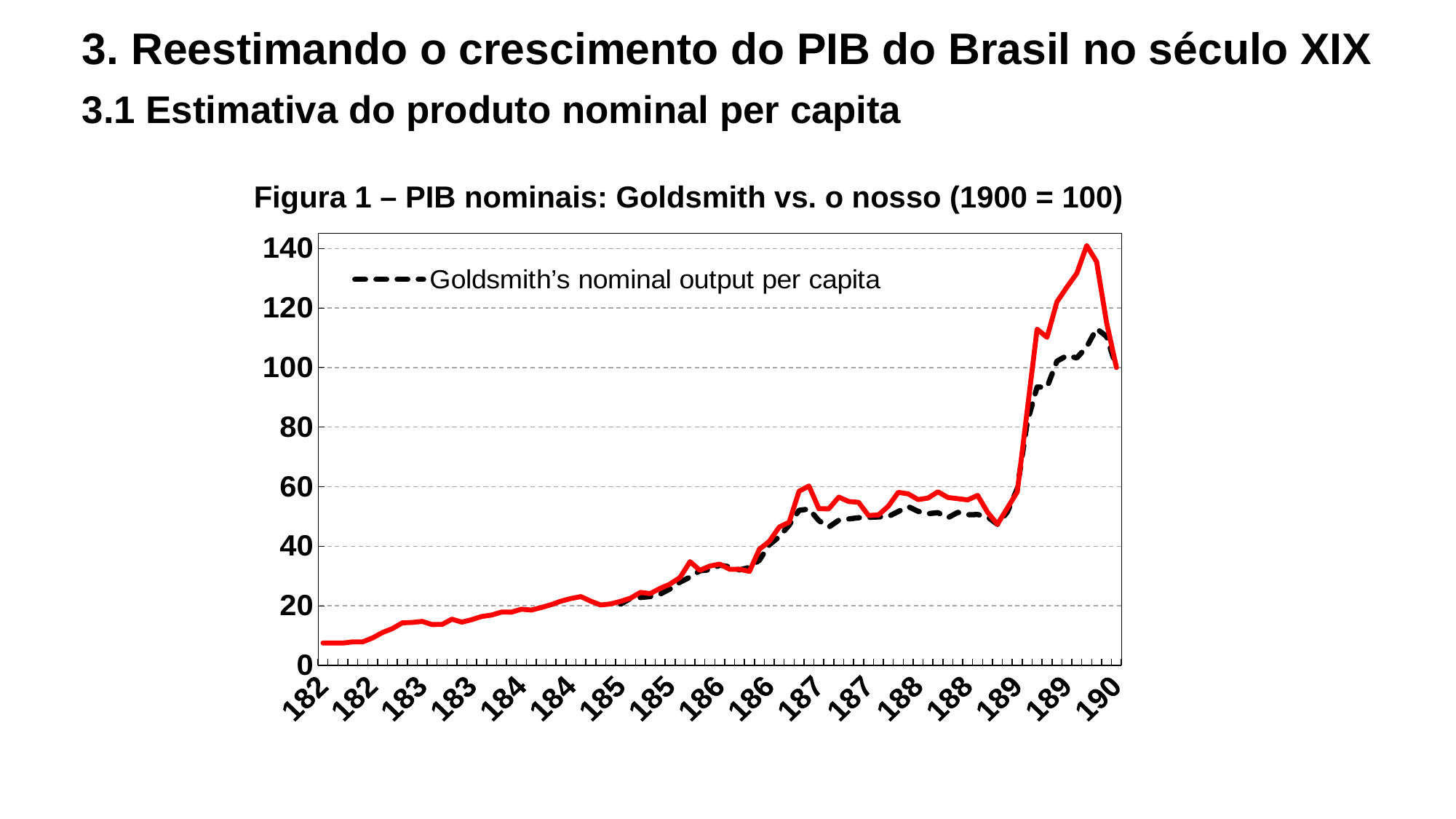
Do the values in Figura 1 generally rise or fall from left to right along the x axis? Rise In Figura 1, is the highest value reached by the red solid line greater or less than 120? greater In Figura 1, is the value of the red solid line at the start of the series greater or less than 40? less In Figura 1, is the value of the red solid line at the start of the series (leftmost point) greater or less than 20? less In Figura 1, which line reaches the higher peak value: the red solid line or the dashed Goldsmith's nominal output per capita line? The red solid line What is the legend entry shown in Figura 1? Goldsmith's nominal output per capita What kind of chart is shown in Figura 1? Line chart What is the title of the chart on the slide? Figura 1 – PIB nominais: Goldsmith vs. o nosso (1900 = 100) How many series does the legend of Figura 1 list? 1 How many lines are plotted in Figura 1? 2